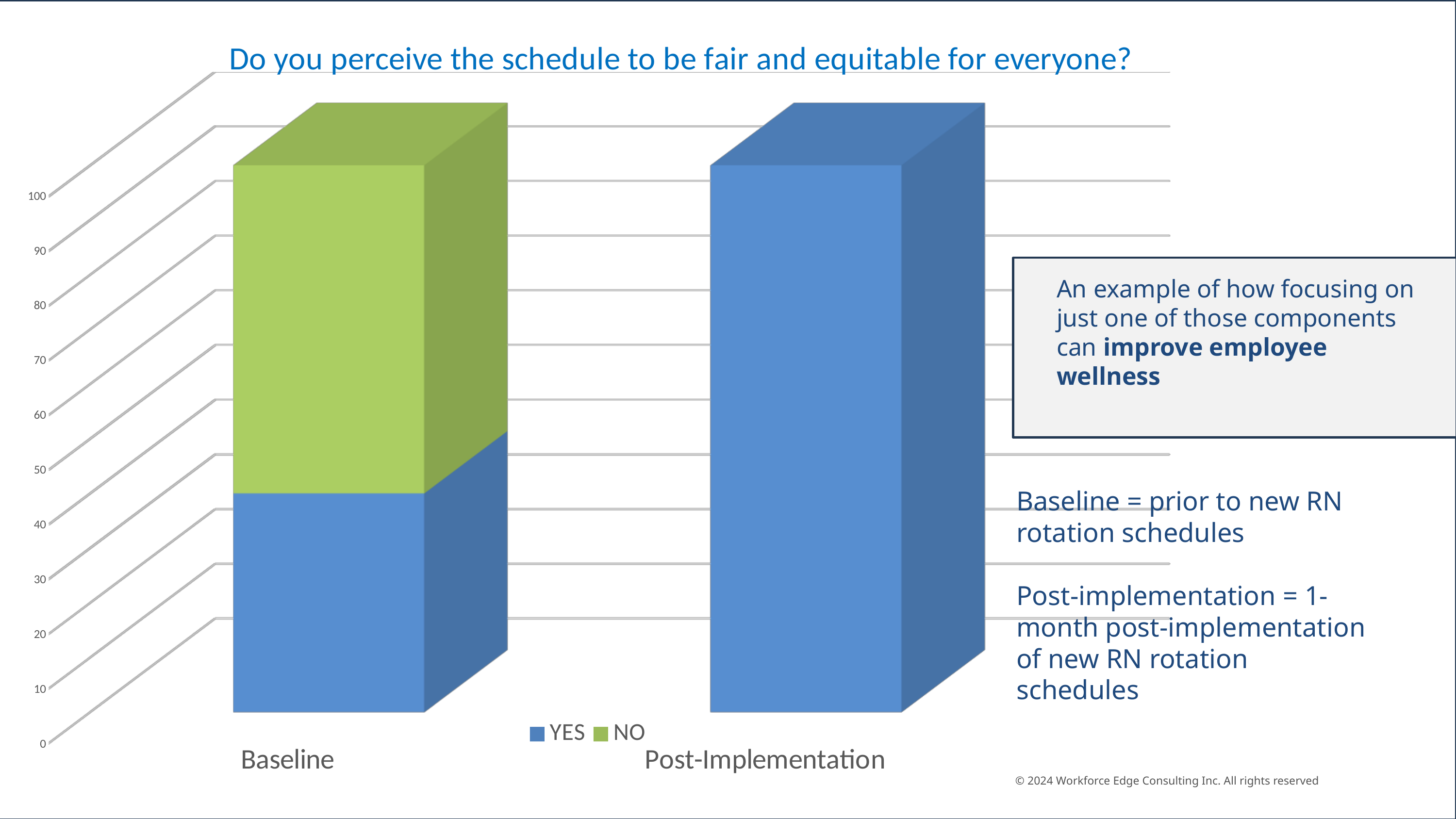
Which category has the highest YES value? Post-Implementation How many categories are shown on the x axis of the chart? 2 Is the YES value for Baseline greater or less than 30? greater Is the YES value for Baseline greater or less than 50? less Which category has the larger YES value, Baseline or Post-Implementation? Post-Implementation How many series does the chart's legend list? 2 What is the title of the chart? Do you perceive the schedule to be fair and equitable for everyone? Is the YES value for Post-Implementation greater or less than 90? greater What kind of chart is shown on the slide? bar chart Does the YES value rise or fall from Baseline to Post-Implementation? rise What are the two series named in the chart's legend? YES and NO